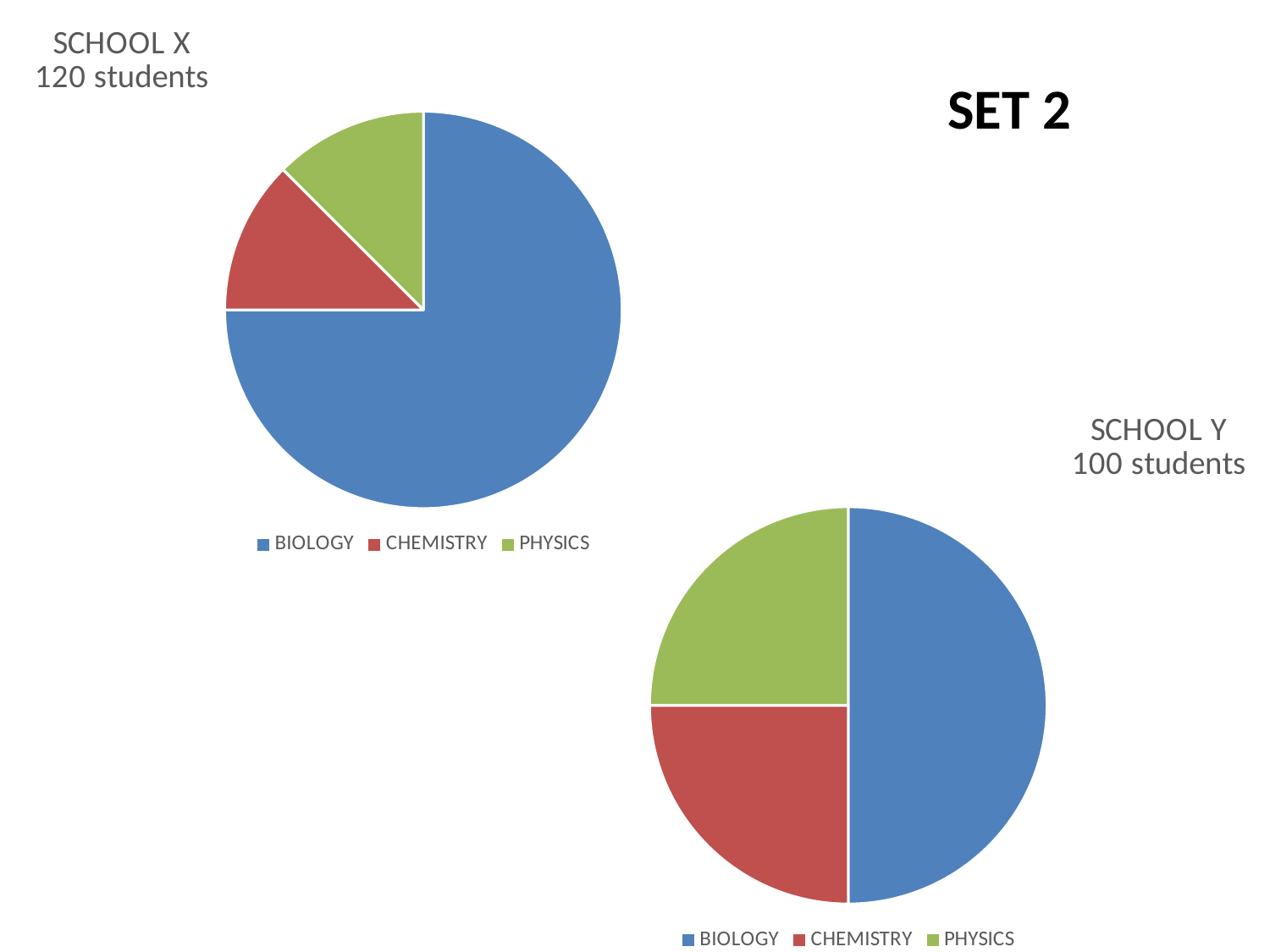
How many students does the School X chart represent, according to its label? 120 students What kind of chart is the School X chart? pie chart In the School Y chart, which subject has the largest slice? BIOLOGY In the School Y chart, which colour represents CHEMISTRY? red What kind of chart is the School Y chart? pie chart How many entries does the legend of the School Y chart list? 3 In the School X chart, which is larger, the BIOLOGY slice or the CHEMISTRY slice? BIOLOGY In the School Y chart, which is larger, the PHYSICS slice or the BIOLOGY slice? BIOLOGY In the School X chart, which subject has the largest slice? BIOLOGY How many slices does the School X pie chart have? 3 How many slices does the School Y pie chart have? 3